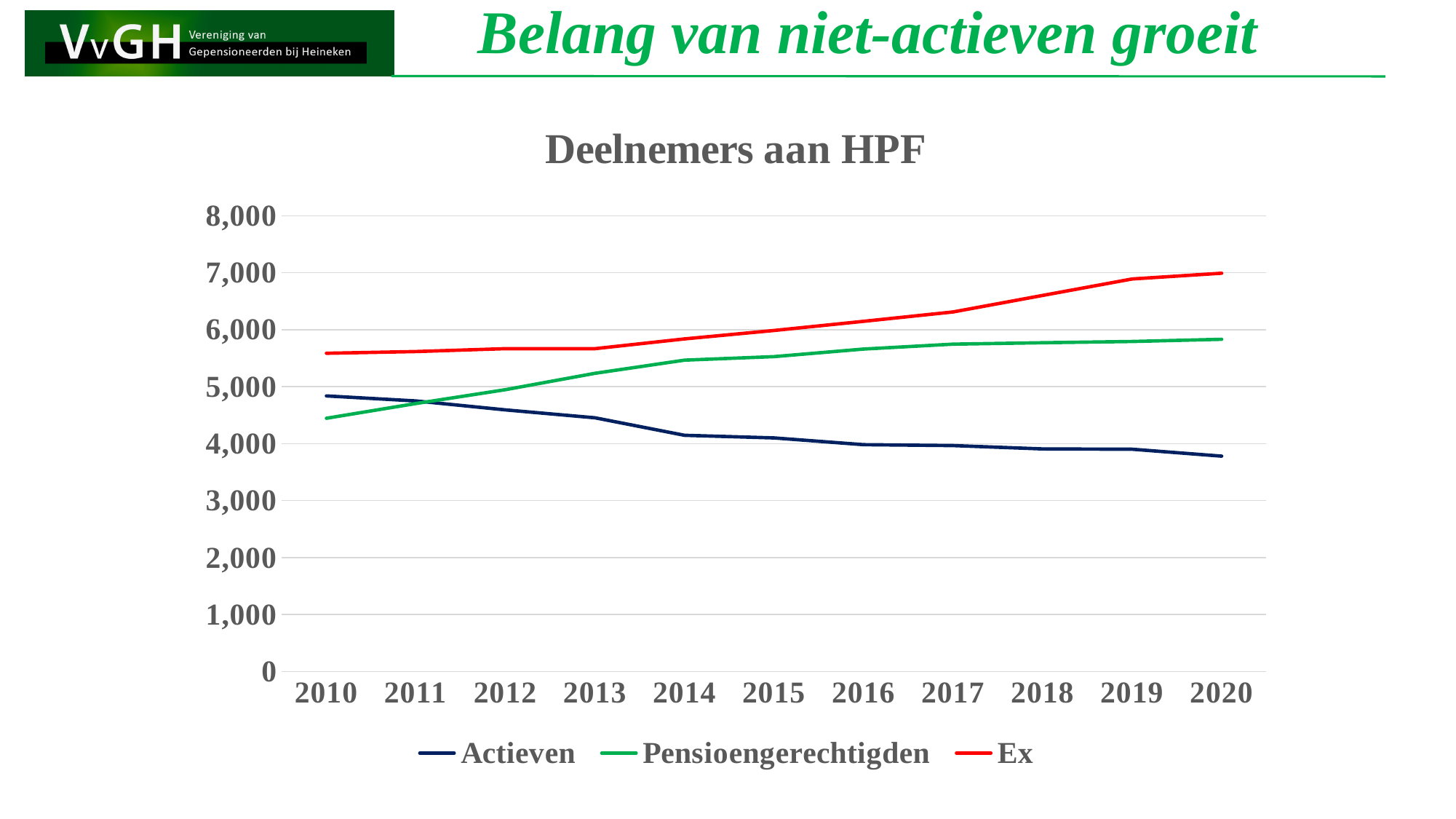
How many years are shown on the x axis? 11 In 2010, which is larger: Actieven or Pensioengerechtigden? Actieven Is the value for Actieven in 2020 greater or less than 4,000? less Which series has the lowest value in 2020? Actieven Which series has the highest value in 2020? Ex Which series has the lowest value in 2010? Pensioengerechtigden Is the value for Ex in 2017 greater or less than 6,000? greater Does the Ex series rise or fall from 2010 to 2020? rise Does the Actieven series rise or fall from 2010 to 2020? fall How many series does the legend list? 3 What is the title of the chart? Deelnemers aan HPF What kind of chart is shown on the slide? line chart